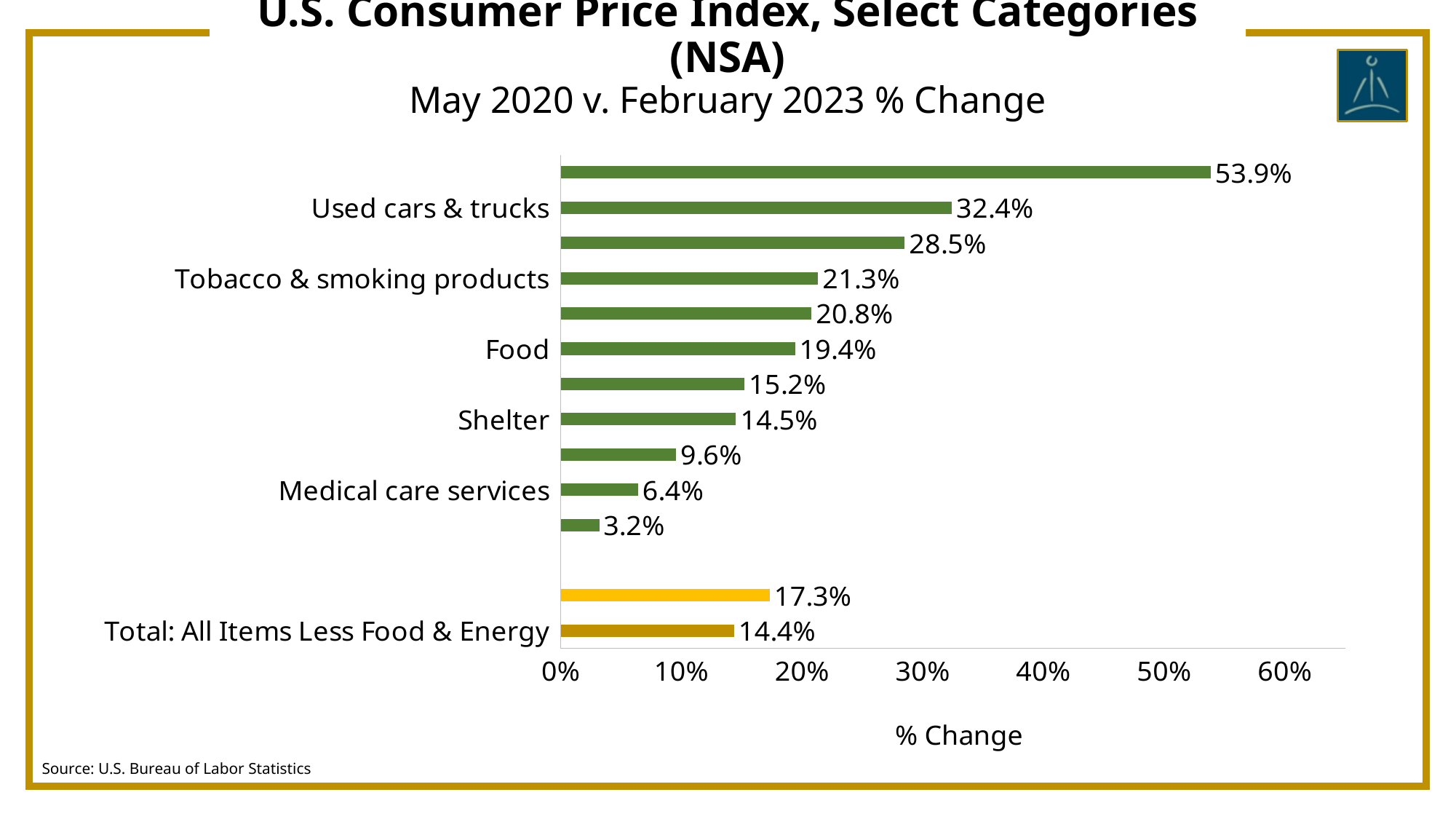
Which has a larger % change, Shelter or Medical care services? Shelter What is the difference between the % change for Used cars & trucks and for Food? 13.0% What is the largest % change value shown on the chart? 53.9% What is the smallest % change value shown on the chart? 3.2% What kind of chart is shown on the slide? Bar chart Is the % change for Food greater or less than 20%? less What is the % change for Tobacco & smoking products? 21.3% What is the % change for Food? 19.4% What is the % change for Total: All Items Less Food & Energy? 14.4% What is the % change for Used cars & trucks? 32.4% What is the % change for Shelter? 14.5% What is the % change for Medical care services? 6.4%